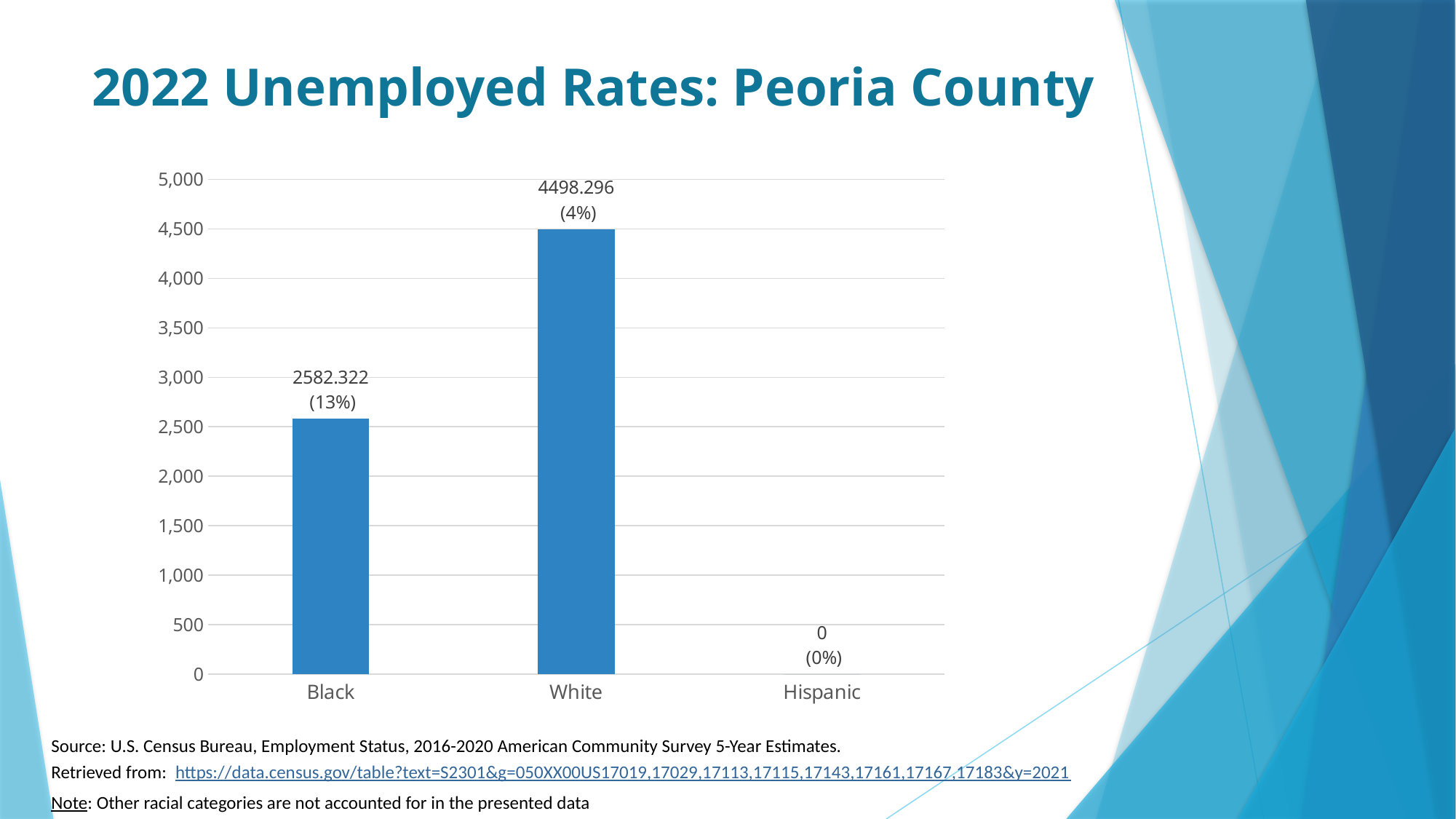
How many categories are shown on the x axis? 3 What is the value shown for Hispanic? 0 Which category has the lowest value? Hispanic What percentage is shown in parentheses for White? 4% Which category has the highest value? White What is the value shown for Black? 2582.322 What kind of chart is shown on the slide? Bar chart What is the title of the slide? 2022 Unemployed Rates: Peoria County What is the value shown for White? 4498.296 Which is larger, the value for Black or the value for White? White What percentage is shown in parentheses for Black? 13% What is the difference between the values for White and Black? 1915.974